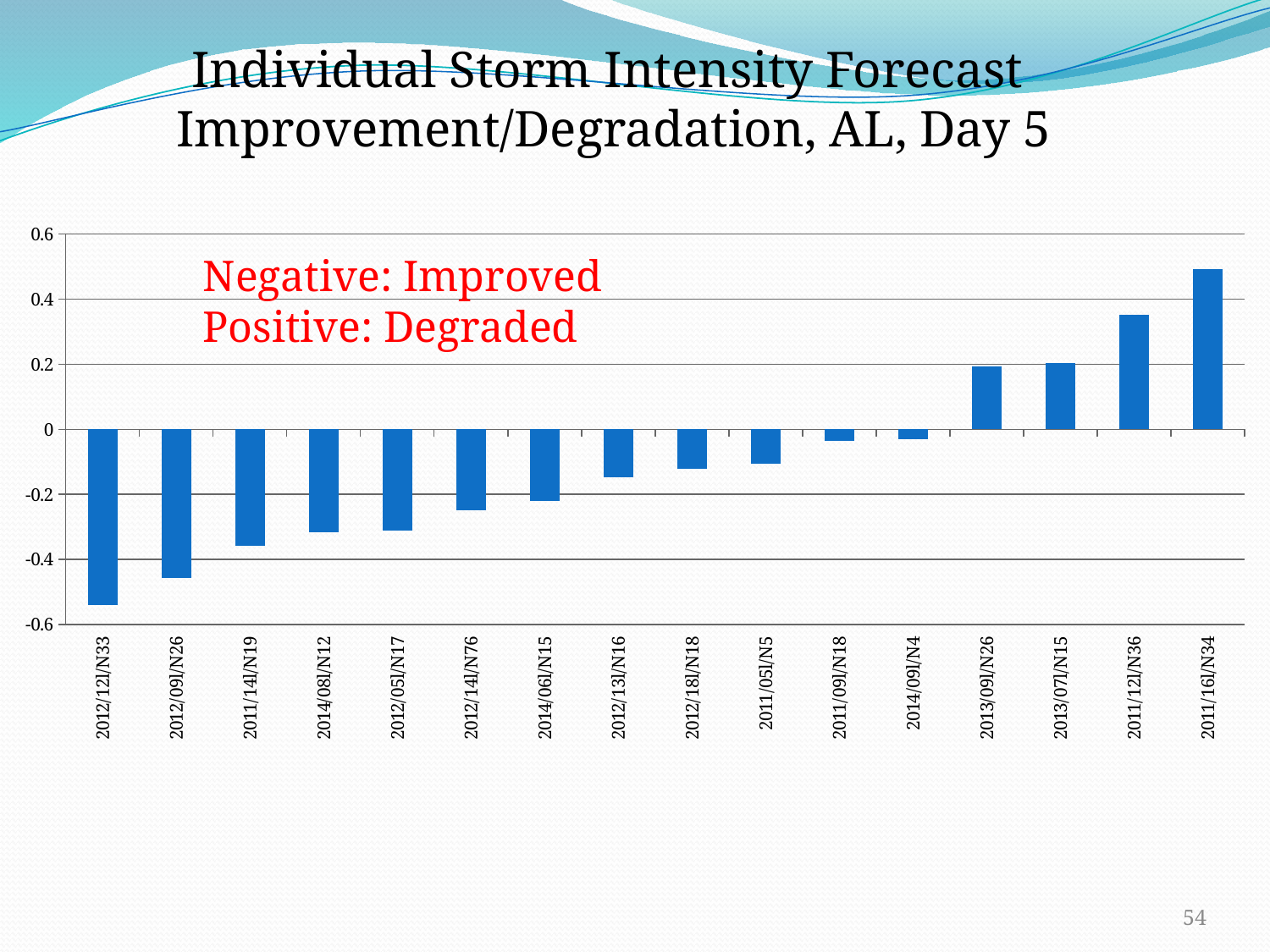
Is the value for 2012/12l/N33 greater or less than -0.4? less How many storms have a positive (degraded) value? 4 Which storm has the lowest (most negative) value? 2012/12l/N33 Which storm has the highest (most positive) value? 2011/16l/N34 What kind of chart is shown on the slide? bar chart Is the value for 2011/16l/N34 greater or less than 0.4? greater Which has the larger value, 2011/16l/N34 or 2011/12l/N36? 2011/16l/N34 Is the value for 2011/12l/N36 greater or less than 0.2? greater How many storm categories are plotted along the x axis? 16 Do the bar values rise or fall moving from left to right along the x axis? rise According to the annotation on the chart, what does a negative value indicate? Improved